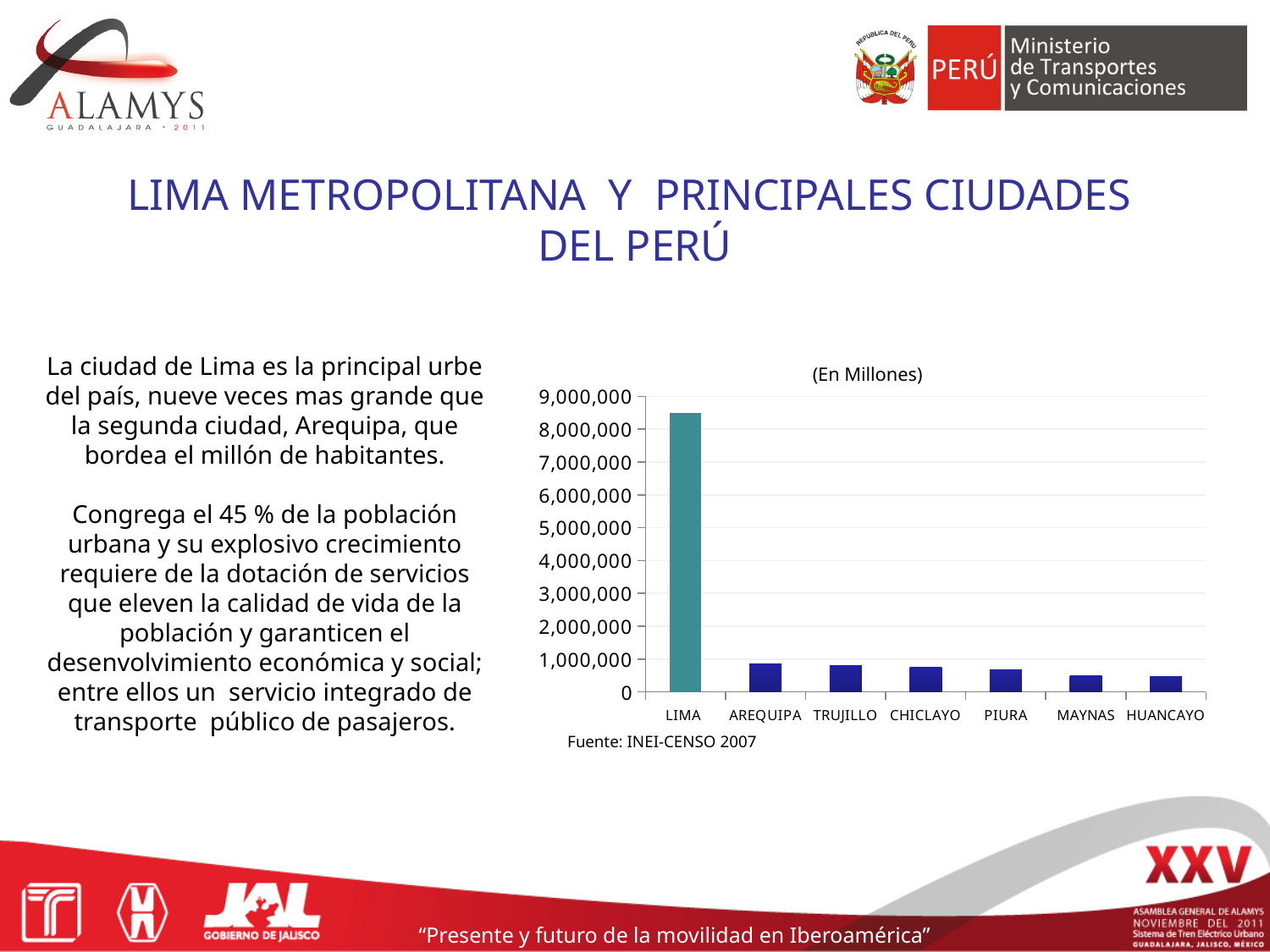
How many cities are shown on the x axis of the chart? 7 Is the value for AREQUIPA greater or less than 1,000,000? less What is the highest value labelled on the chart's vertical axis? 9,000,000 Is the value for LIMA greater or less than 8,000,000? greater Is the value for PIURA greater or less than 1,000,000? less Which has the larger value, AREQUIPA or PIURA? AREQUIPA Do the bar values rise or fall from left to right along the x axis? fall Which has the larger value, LIMA or AREQUIPA? LIMA What kind of chart is shown on the slide? Bar chart What source is cited below the chart? Fuente: INEI-CENSO 2007 Which city has the highest bar in the chart? LIMA What is the title shown above the chart? (En Millones)